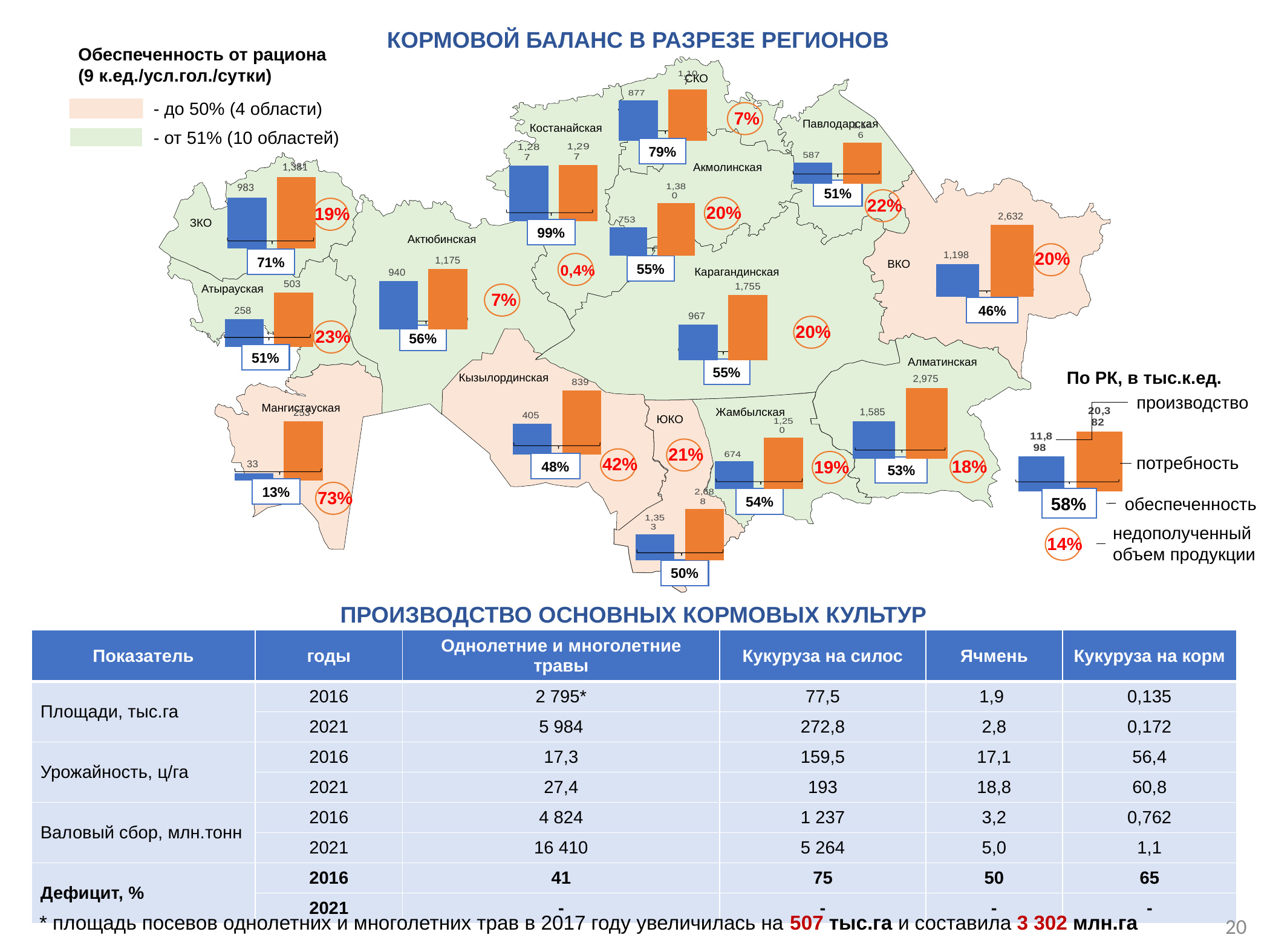
On the map chart for the ВКО region, what is the value of the orange bar (потребность)? 2,632 Among the regional charts on the map, which region has the lowest производство (blue bar) value? Мангистауская On the map chart for the ВКО region, what is the difference between the потребность bar and the производство bar? 1,434 On the map chart for the Мангистауская region, what is the difference between the потребность bar and the производство bar? 220 On the 'По РК, в тыс.к.ед.' chart at the right, what is the value of the потребность bar? 20,382 How many series does the legend at the right of the map list for the bars (производство, потребность)? 2 On the map charts, what colour is the bar representing потребность? orange On the map chart for the Алматинская region, what is the value of the blue bar (производство)? 1,585 Among the regional charts on the map, which region has the highest потребность (orange bar) value? Алматинская On the map chart for the Мангистауская region, what is the value of the blue bar (производство)? 33 On the map chart for the Карагандинская region, which bar is larger: производство or потребность? потребность What kind of chart is used for each region on the map? bar chart